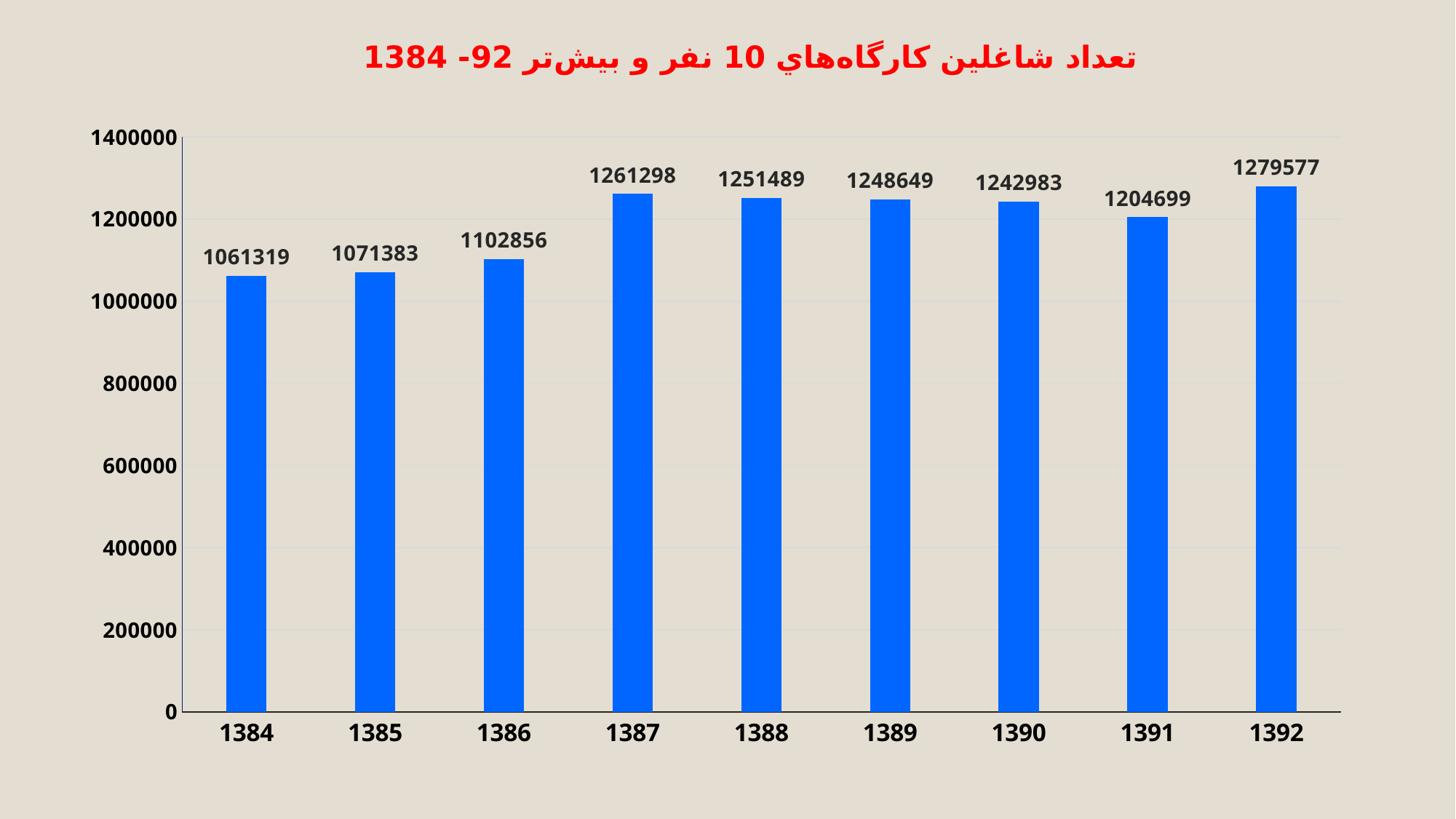
Which year has the lowest value? 1384 What is the difference between the values for 1387 and 1386? 158442 What is the value for 1391? 1204699 What is the difference between the values for 1392 and 1384? 218258 Is the value for 1386 greater or less than 1200000? less Do the values rise or fall from 1384 to 1387? rise Which is larger, the value for 1390 or the value for 1391? 1390 Which year has the highest value? 1392 What kind of chart is this? bar chart What is the value for 1387? 1261298 How many years are shown on the x axis? 9 What is the value for 1384? 1061319